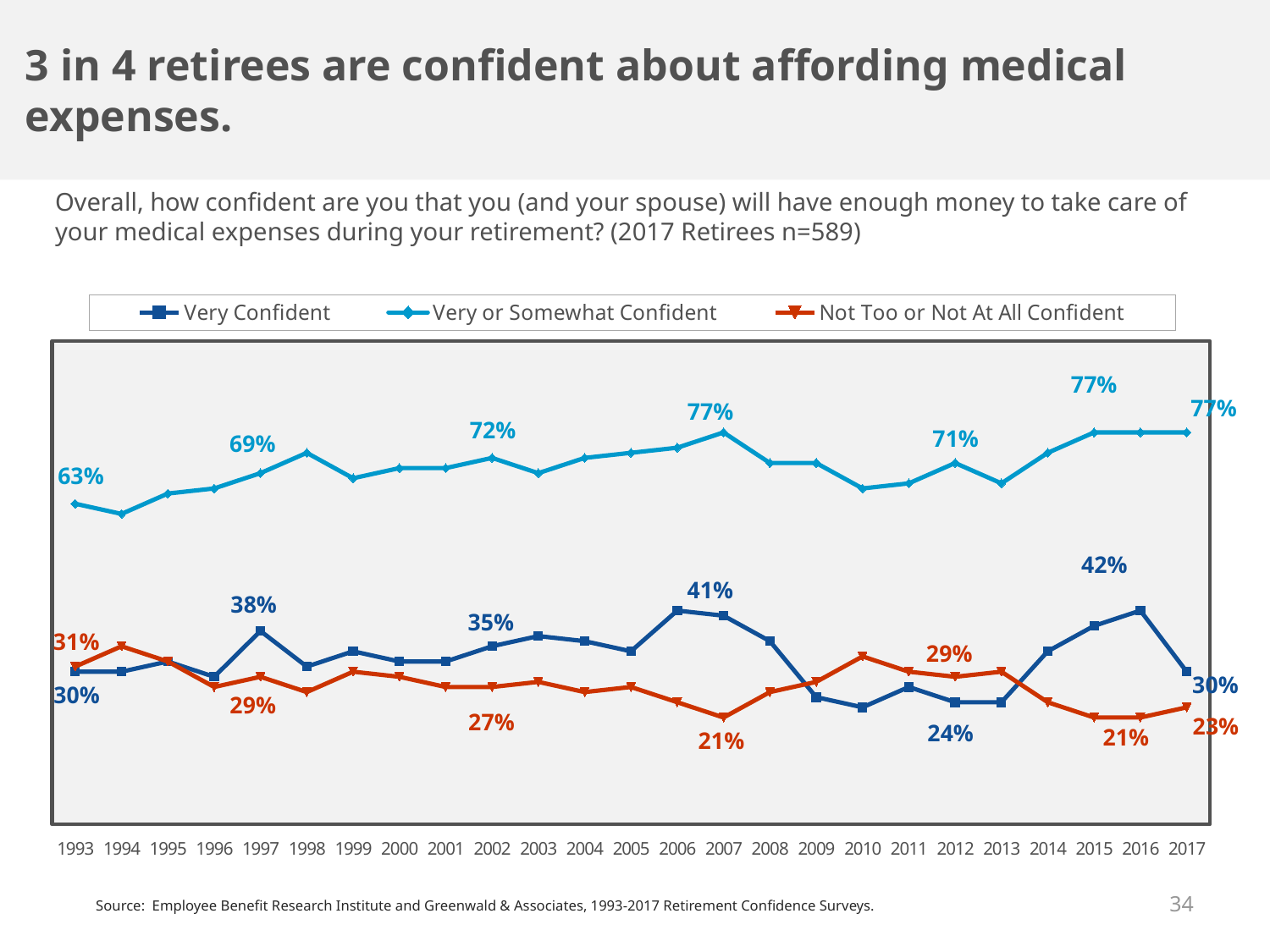
What is the value for Very Confident in 2017? 30% What is the difference between Very or Somewhat Confident and Not Too or Not At All Confident in 2017? 54 percentage points Does the Very or Somewhat Confident line rise or fall overall from 1993 to 2017? Rise What is the value for Very or Somewhat Confident in 1993? 63% How many series does the legend list? 3 In 2012, which is larger: Very Confident or Not Too or Not At All Confident? Not Too or Not At All Confident What is the value for Very or Somewhat Confident in 2017? 77% Which series has the highest values across all years? Very or Somewhat Confident What type of chart is shown on the slide? Line chart What is the value for Not Too or Not At All Confident in 2012? 29% What is the value for Very Confident in 2012? 24% How many years are shown along the x axis? 25